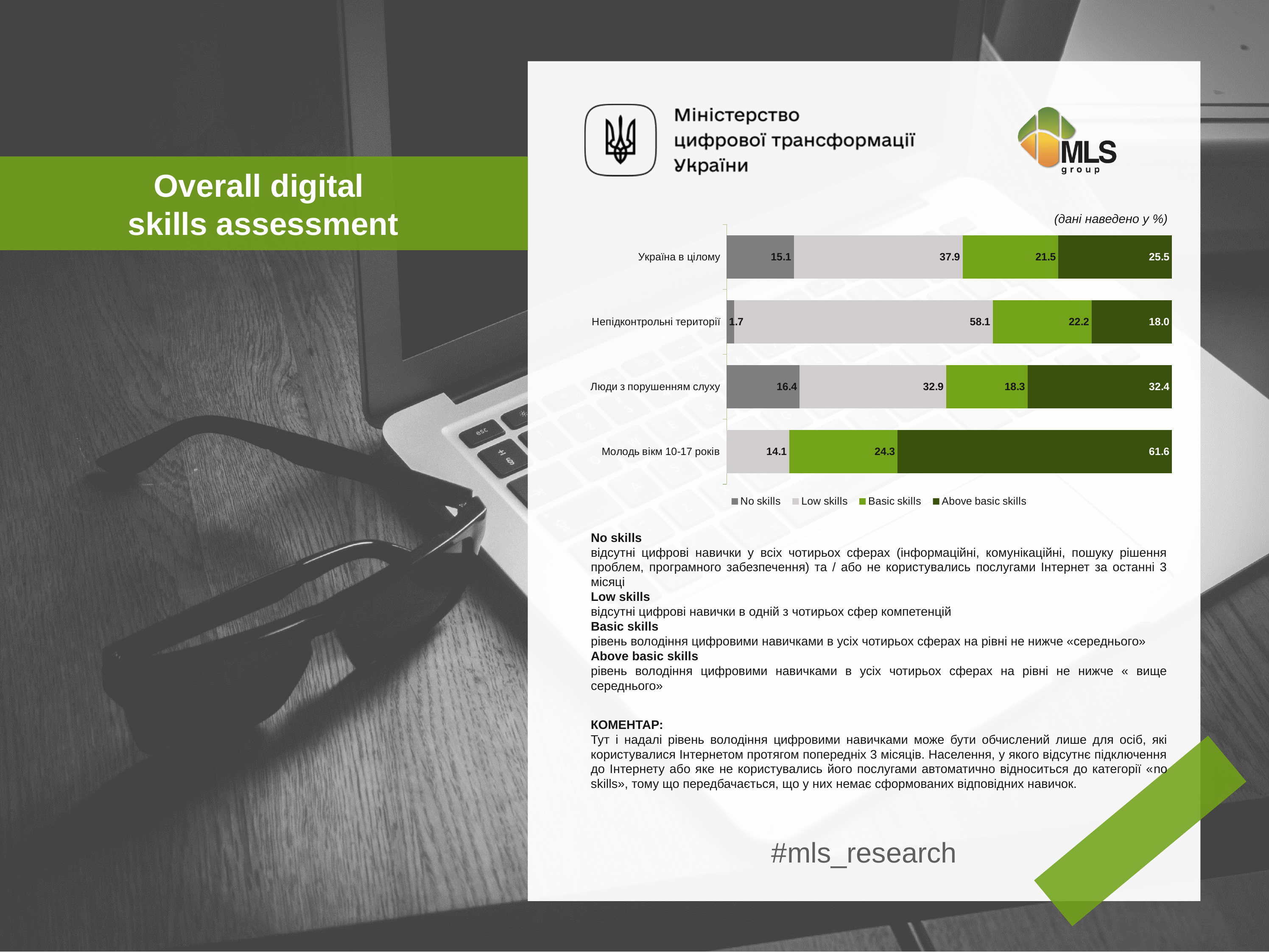
How many series does the legend list? 4 What is the difference between the Low skills values for Люди з порушенням слуху and Молодь вікм 10-17 років? 18.8 What is the difference between the Above basic skills values for Україна в цілому and Непідконтрольні території? 7.5 What kind of chart is shown on the slide? Stacked bar chart What is the Low skills value for Україна в цілому? 37.9 What is the Above basic skills value for Молодь вікм 10-17 років? 61.6 Which category has the highest Low skills value? Непідконтрольні території Which category has the lowest Above basic skills value? Непідконтрольні території What is the Basic skills value for Люди з порушенням слуху? 18.3 Which category has the highest No skills value? Люди з порушенням слуху Which has the larger Basic skills value, Україна в цілому or Непідконтрольні території? Непідконтрольні території How many categories are shown in the chart? 4